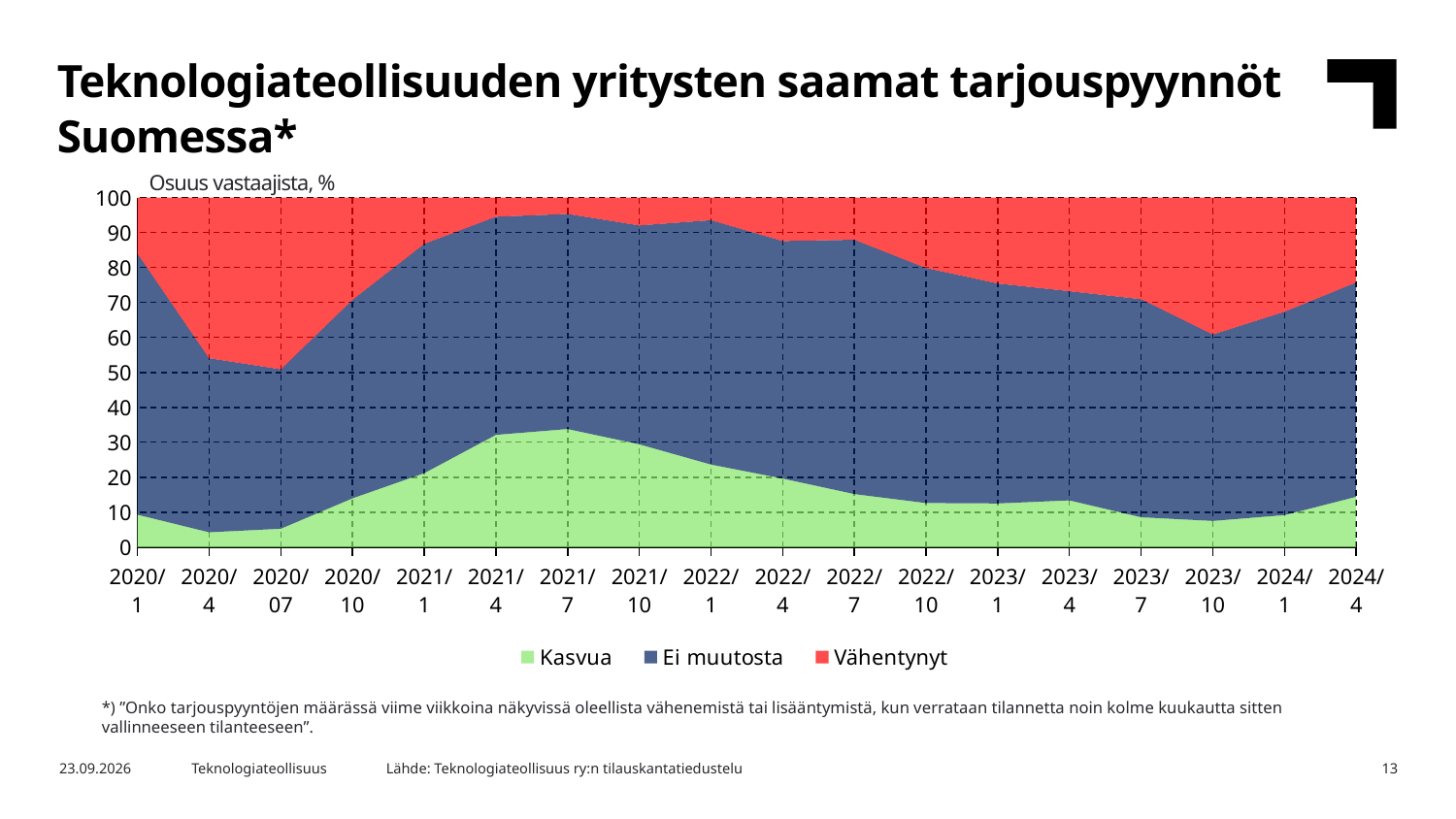
How many series does the chart legend list? 3 Is the value for Kasvua at 2021/7 greater or less than 20? greater What kind of chart is shown on the slide? Area chart What is the title of the chart on the slide? Teknologiateollisuuden yritysten saamat tarjouspyynnöt Suomessa* How many time points are shown along the x axis of the chart? 18 Is the value for Kasvua at 2023/10 greater or less than 10? less Which is larger: the Kasvua value at 2021/7 or at 2020/4? 2021/7 At which time point does the Kasvua series reach its highest value? 2021/7 Is the combined share of Kasvua and Ei muutosta at 2021/7 greater or less than 90? greater Does the Kasvua series rise or fall from 2021/7 to 2023/10? fall What label is shown above the vertical axis of the chart? Osuus vastaajista, %